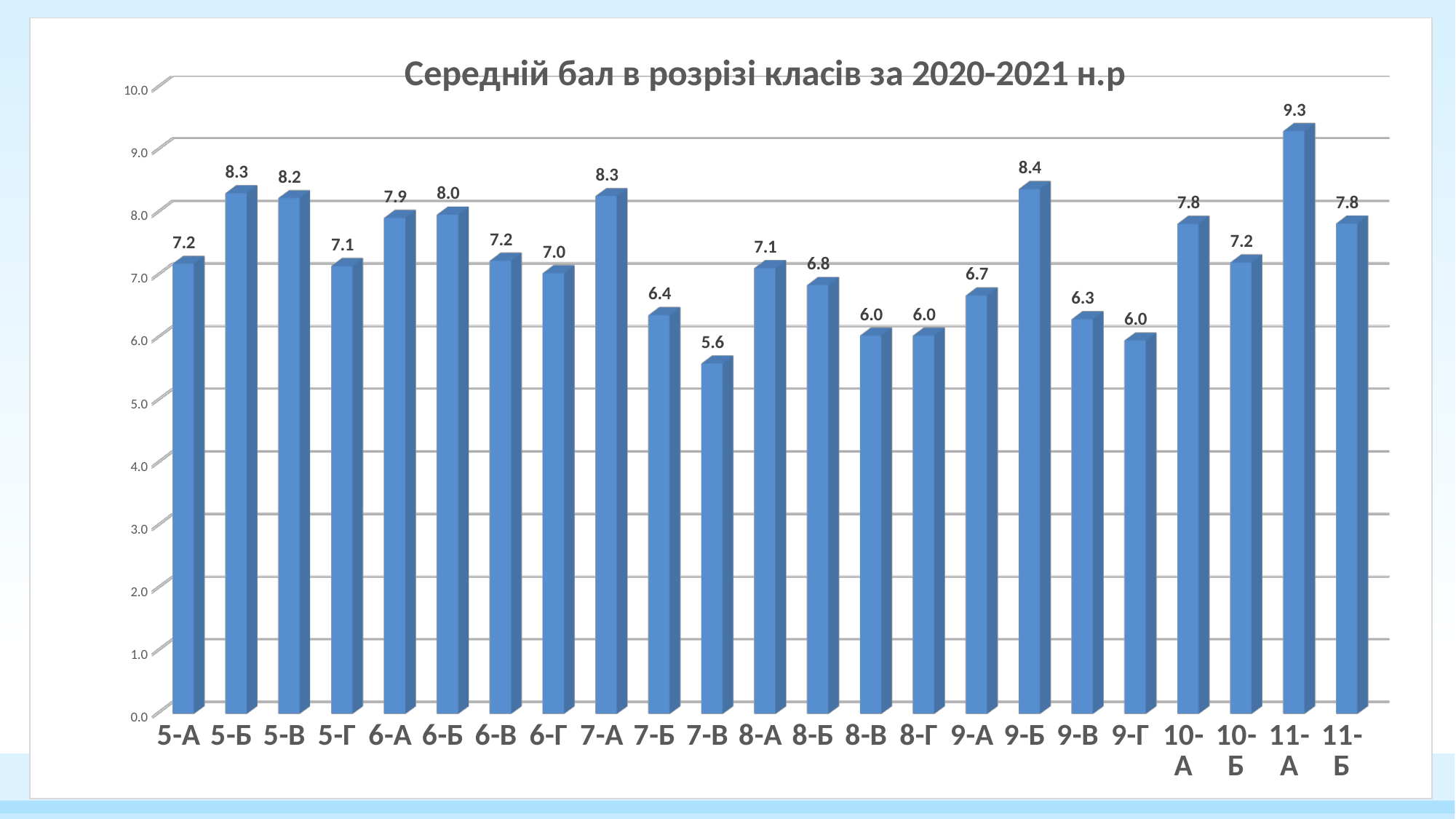
What is the difference between the values for 11-А and 7-В? 3.7 How many classes are shown on the x axis? 23 What is the value shown for class 10-А? 7.8 Which is larger, the value for 6-А or the value for 8-Б? 6-А What is the difference between the values for 9-Б and 9-Г? 2.4 What is the title of the chart? Середній бал в розрізі класів за 2020-2021 н.р What is the average score for class 9-Б? 8.4 What kind of chart is shown on the slide? Bar chart Which class has the highest average score? 11-А What is the average score for class 5-Б? 8.3 Which class has the lowest average score? 7-В What is the value shown for class 7-В? 5.6